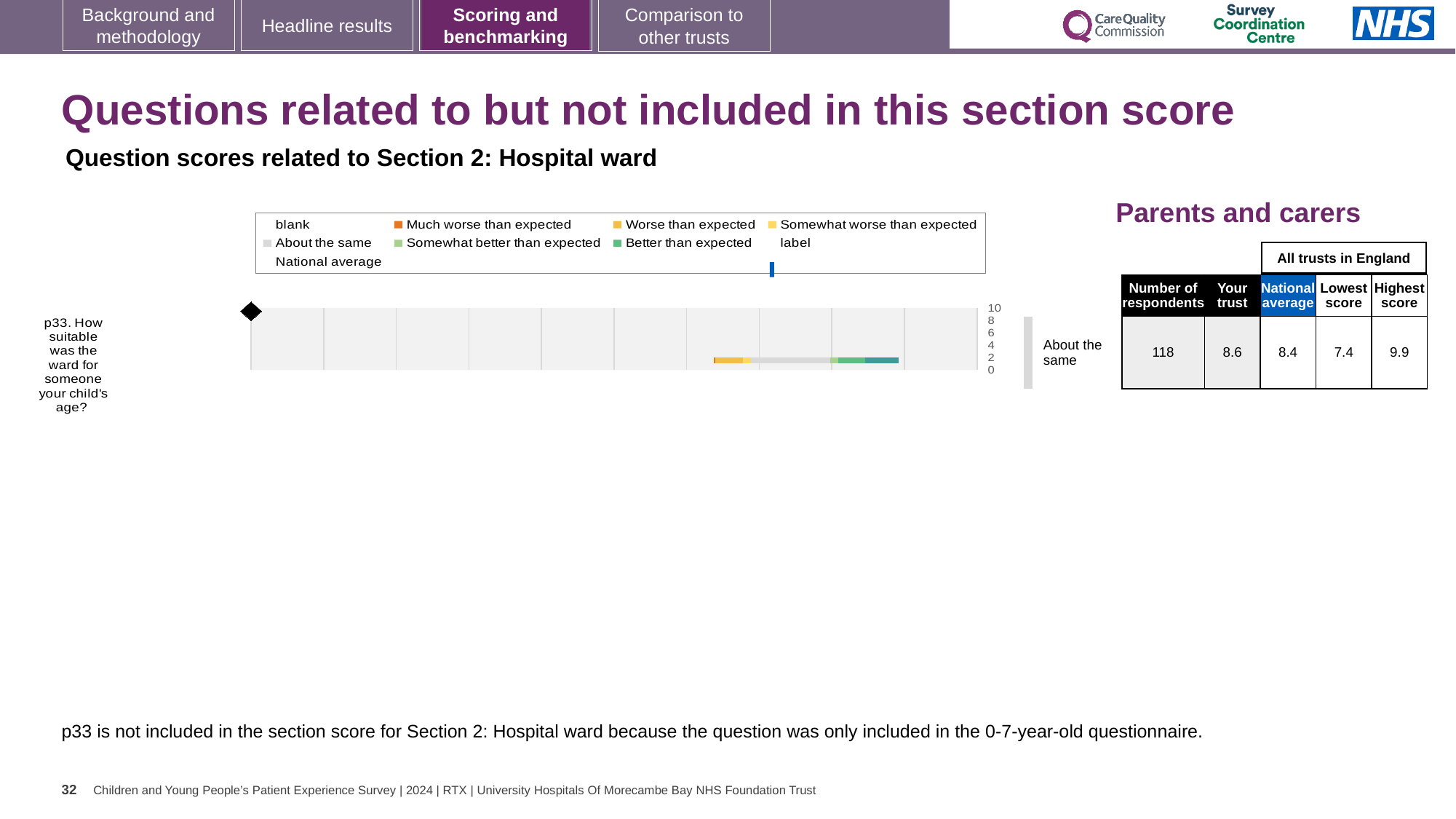
What benchmark category label is shown to the right of the p33 bar? About the same What is the 'Your trust' score for p33? 8.6 How many questions are plotted in the chart? 1 What kind of chart is used to show the p33 question score? bar chart Which is larger for p33, the 'Your trust' score or the national average? Your trust How many respondents answered p33? 118 What is the lowest score among all trusts in England for p33? 7.4 Which question is plotted in the chart? p33. How suitable was the ward for someone your child's age? What is the highest score among all trusts in England for p33? 9.9 What is the national average score for p33? 8.4 What is the difference between the highest score and the lowest score for p33? 2.5 How many entries does the chart legend list? 9